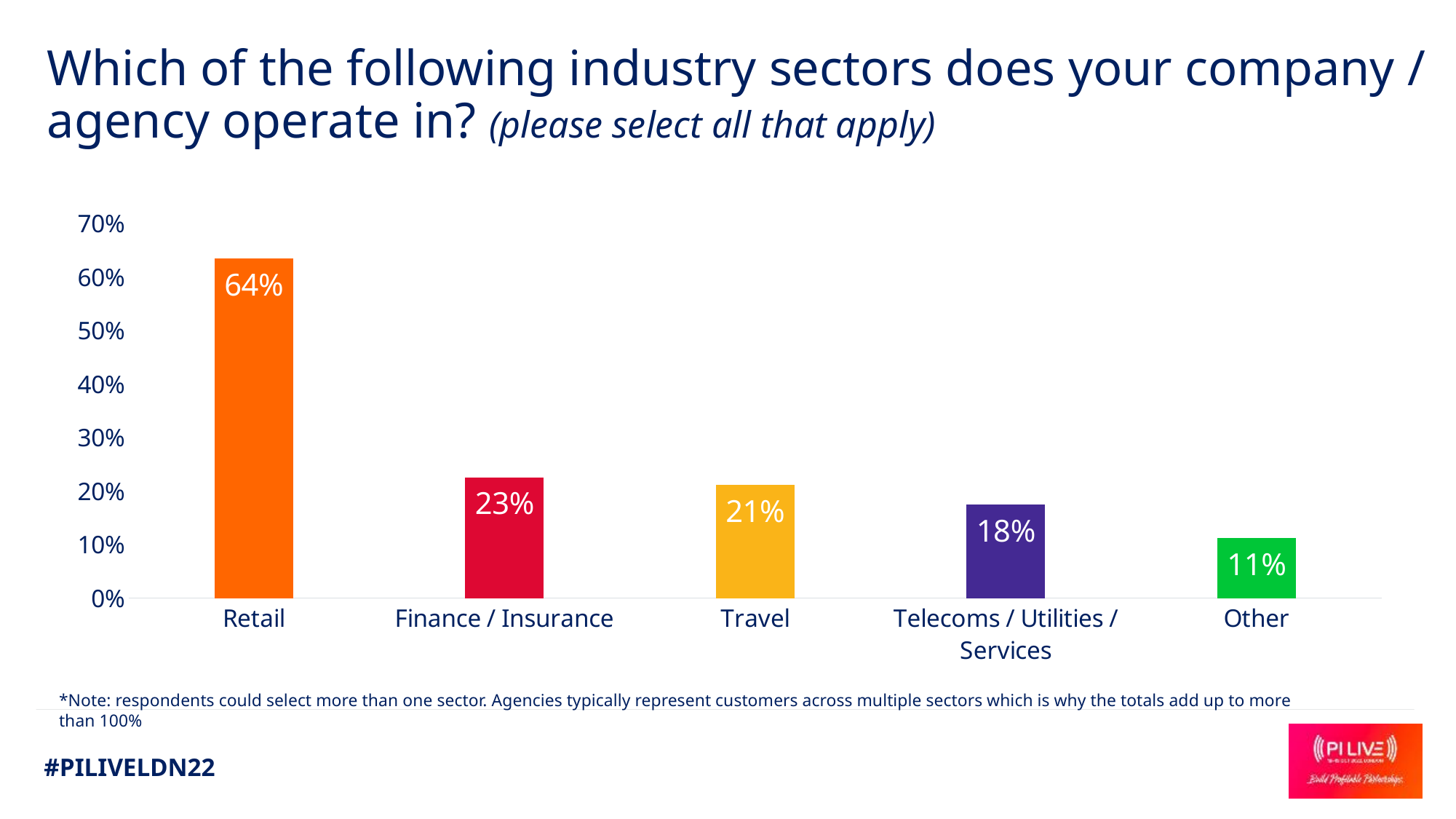
Is the value for Retail greater or less than 60%? greater Which category has the lowest percentage? Other How many industry sector categories are shown on the chart? 5 What is the value shown for Finance / Insurance? 23% What is the value for the Other category? 11% What percentage is shown for Telecoms / Utilities / Services? 18% What percentage of respondents operate in the Retail sector? 64% What is the difference between the Retail and Travel percentages? 43% What is the highest value shown on the vertical axis? 70% Which industry sector has the highest percentage? Retail Which is larger, the value for Finance / Insurance or the value for Telecoms / Utilities / Services? Finance / Insurance What kind of chart is shown on the slide? Bar chart